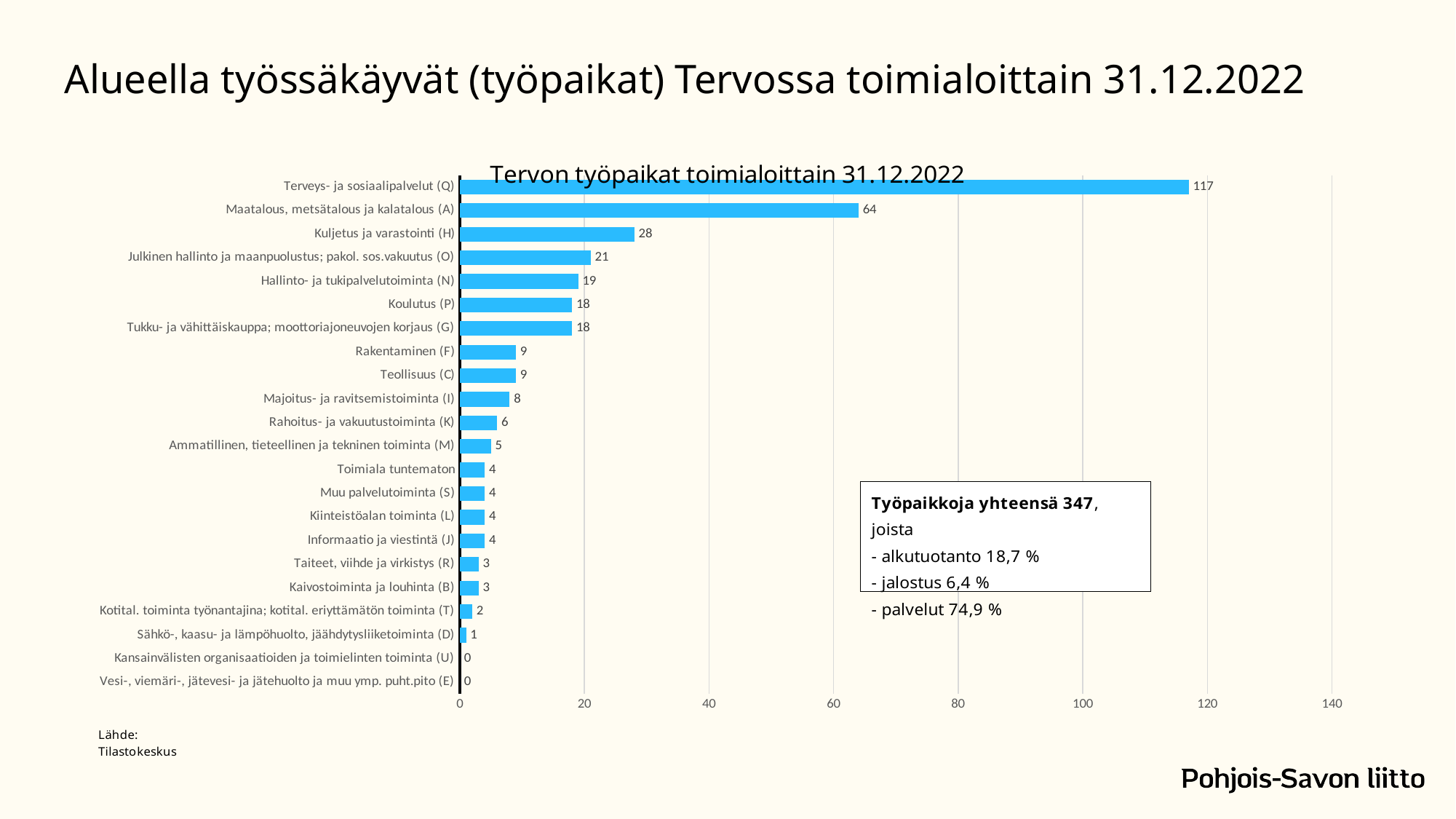
What is the value for Kuljetus ja varastointi (H)? 28 Which is larger, Koulutus (P) or Rahoitus- ja vakuutustoiminta (K)? Koulutus (P) How many categories are shown in the chart? 22 What kind of chart is shown? bar chart Which category has the highest value? Terveys- ja sosiaalipalvelut (Q) Is the value for Maatalous, metsätalous ja kalatalous (A) greater or less than 60? greater What is the title of the chart? Tervon työpaikat toimialoittain 31.12.2022 What is the value for Terveys- ja sosiaalipalvelut (Q)? 117 What is the value for Rakentaminen (F)? 9 What is the value for Sähkö-, kaasu- ja lämpöhuolto, jäähdytysliiketoiminta (D)? 1 What is the difference between Terveys- ja sosiaalipalvelut (Q) and Maatalous, metsätalous ja kalatalous (A)? 53 What is the difference between Julkinen hallinto ja maanpuolustus; pakol. sos.vakuutus (O) and Hallinto- ja tukipalvelutoiminta (N)? 2